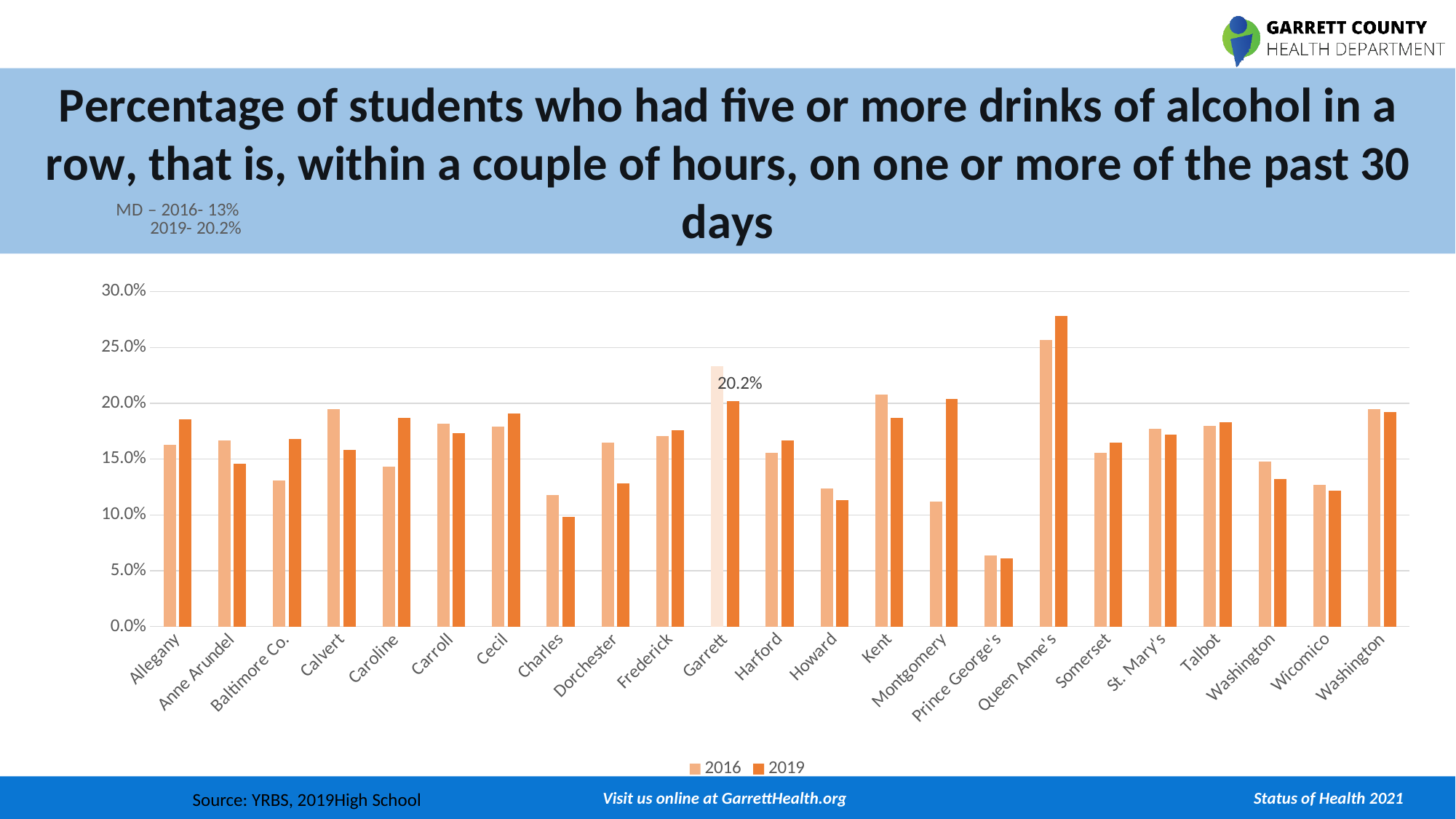
What are the two series named in the legend? 2016 and 2019 Is the 2019 value for Howard greater or less than 15.0%? less What kind of chart is shown on the slide? Bar chart Is the 2016 value for Queen Anne's greater or less than 25.0%? greater How many series does the legend list? 2 What is the 2019 value for Garrett? 20.2% How many counties are shown along the x axis? 23 Is the 2016 value for Montgomery greater or less than 15.0%? less For Calvert, which is larger: the 2016 value or the 2019 value? 2016 For Allegany, which is larger: the 2016 value or the 2019 value? 2019 Which county has the highest 2019 value? Queen Anne's Which county has the lowest 2019 value? Prince George's